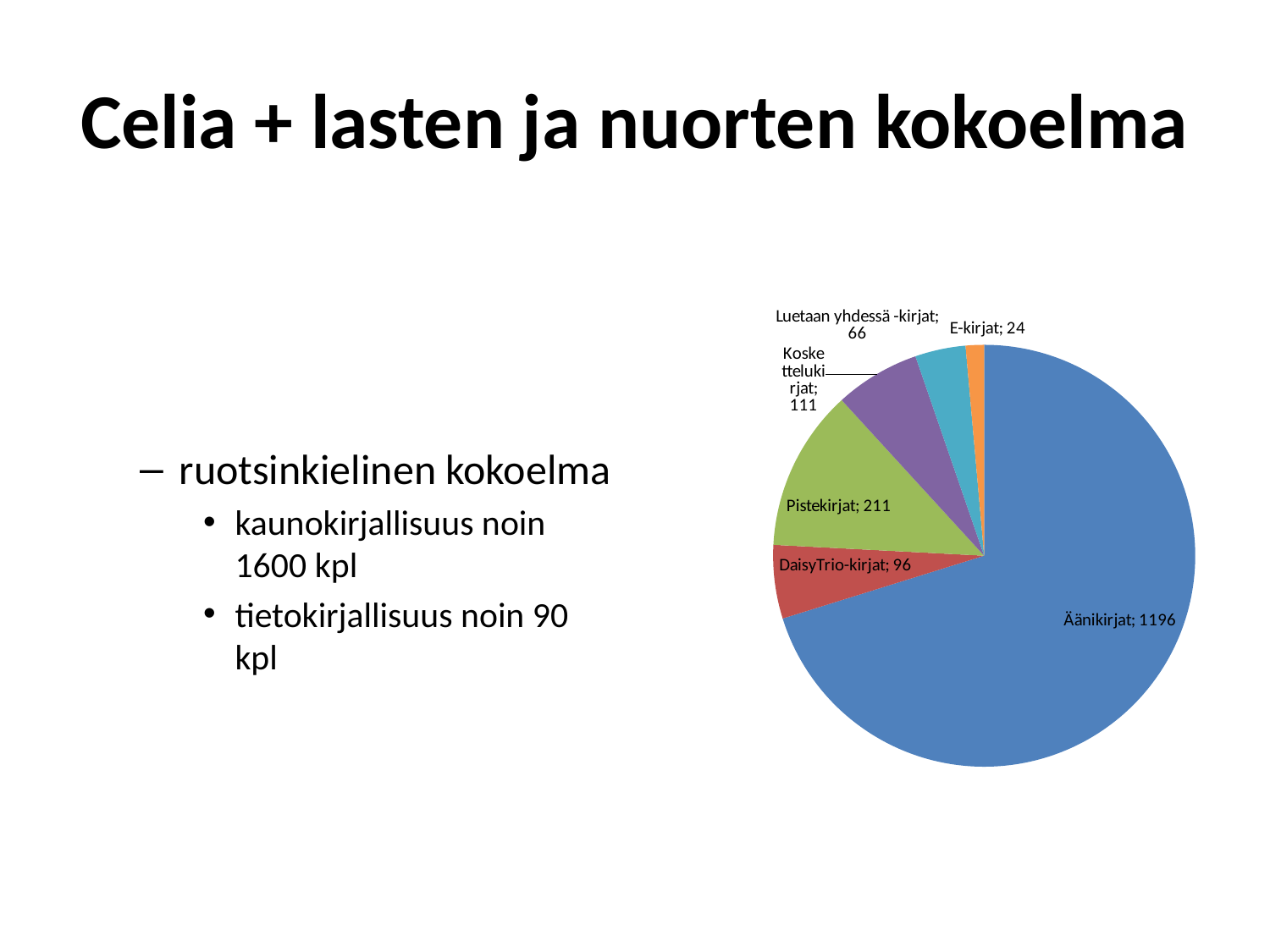
How many slices does the pie chart have? 6 What is the value for Koskettelukirjat in the pie chart? 111 Which category has the largest slice in the pie chart? Äänikirjat What is the total of all the values shown in the pie chart? 1704 What is the value for Äänikirjat in the pie chart? 1196 What is the value for DaisyTrio-kirjat in the pie chart? 96 What is the value for Pistekirjat in the pie chart? 211 What is the difference between the values for Pistekirjat and Koskettelukirjat? 100 What kind of chart is shown on the slide? pie chart Which category has the smallest slice in the pie chart? E-kirjat What is the value for E-kirjat in the pie chart? 24 Which is larger, the value for DaisyTrio-kirjat or the value for Luetaan yhdessä -kirjat? DaisyTrio-kirjat